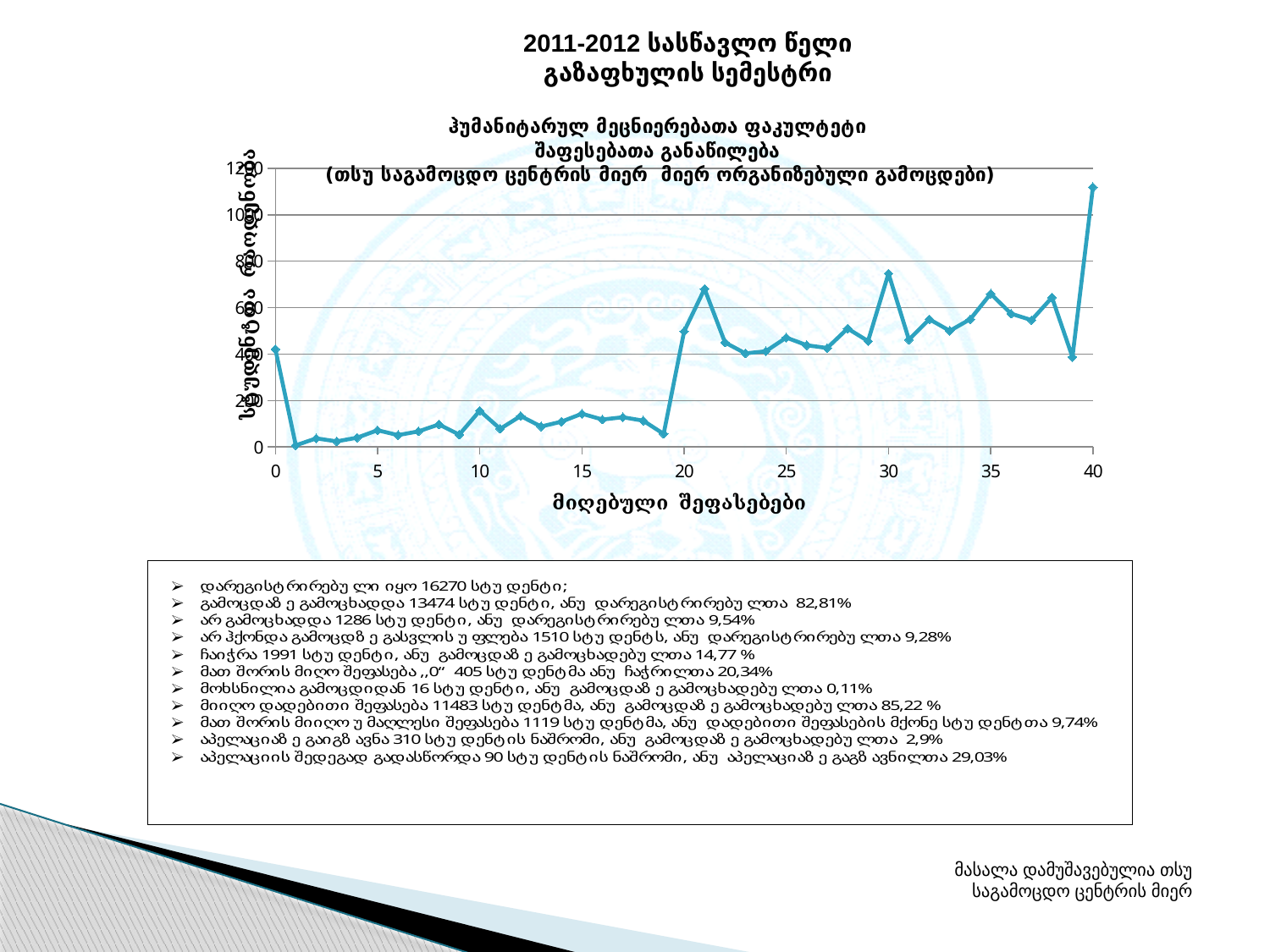
Is the value at x = 40 greater or less than 100? greater Which is larger, the value at x = 30 or the value at x = 10? x = 30 What is the title of the x axis of the chart? მიღებული შეფასებები Which is larger, the value at x = 40 or the value at x = 0? x = 40 What kind of chart is shown on the slide? line chart Is the value at x = 30 greater or less than 60? greater Does the line rise or fall between x = 19 and x = 21? rise What is the highest value shown on the y axis of the chart? 1200 Is the value at x = 0 greater or less than 20? greater At which x-axis value does the line reach its highest point? 40